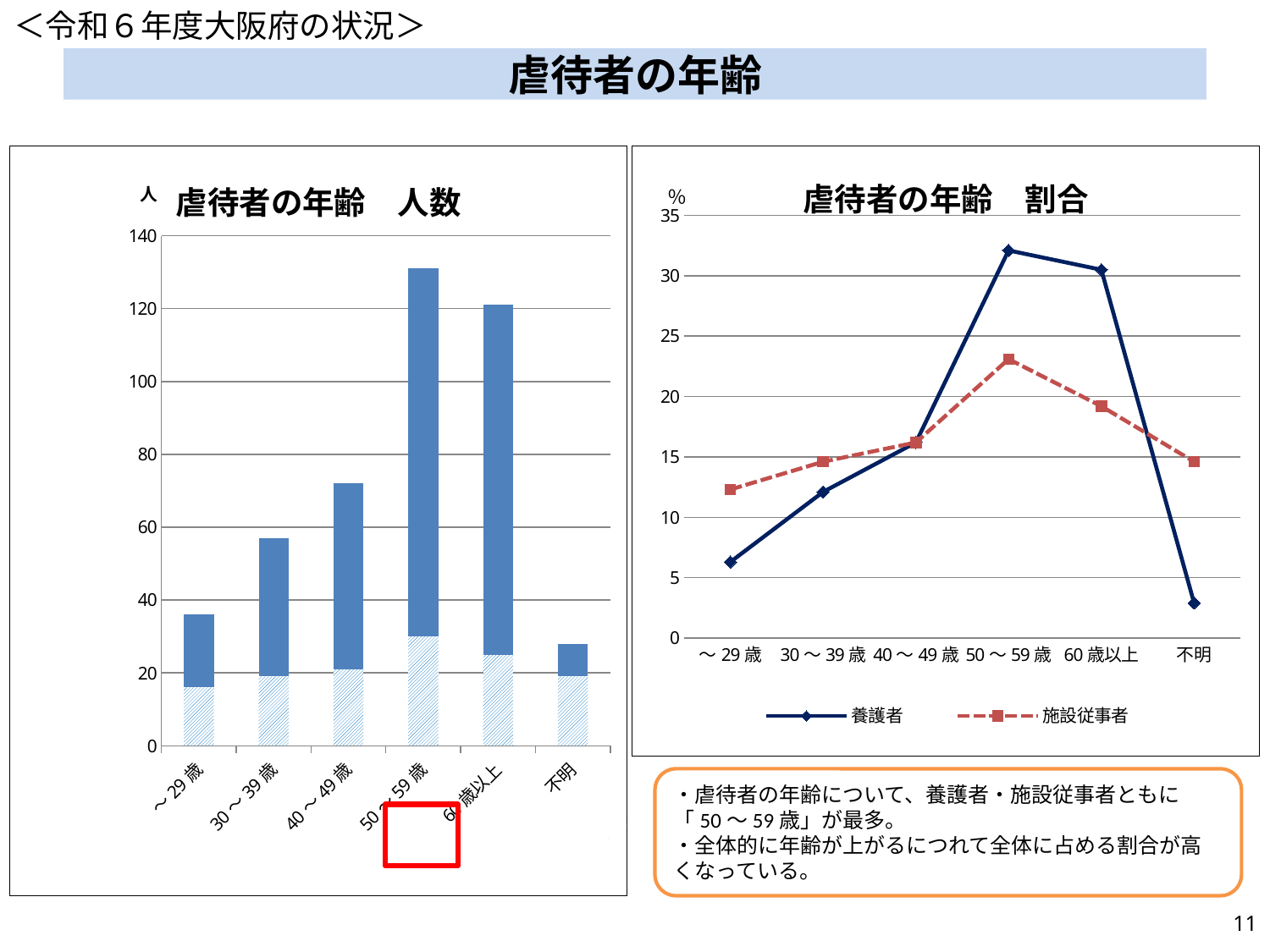
What kind of chart is the left chart titled 虐待者の年齢 人数? bar chart In the left chart 虐待者の年齢 人数, which age category has the tallest bar? 50～59歳 How many age categories are shown on the x axis of the left chart 虐待者の年齢 人数? 6 In the left chart 虐待者の年齢 人数, which category has the shortest bar? 不明 In the right chart 虐待者の年齢 割合, at which category is the 養護者 line lowest? 不明 How many series does the legend of the right chart 虐待者の年齢 割合 list? 2 What kind of chart is the right chart titled 虐待者の年齢 割合? line chart In the left chart 虐待者の年齢 人数, is the total bar for 50～59歳 greater or less than 120? greater In the right chart 虐待者の年齢 割合, which series has the higher value at ～29歳, 養護者 or 施設従事者? 施設従事者 In the right chart 虐待者の年齢 割合, is the 養護者 value for 50～59歳 greater or less than 30? greater In the left chart 虐待者の年齢 人数, is the total bar for 不明 greater or less than 40? less In the right chart 虐待者の年齢 割合, at which age category does the 養護者 line reach its highest point? 50～59歳